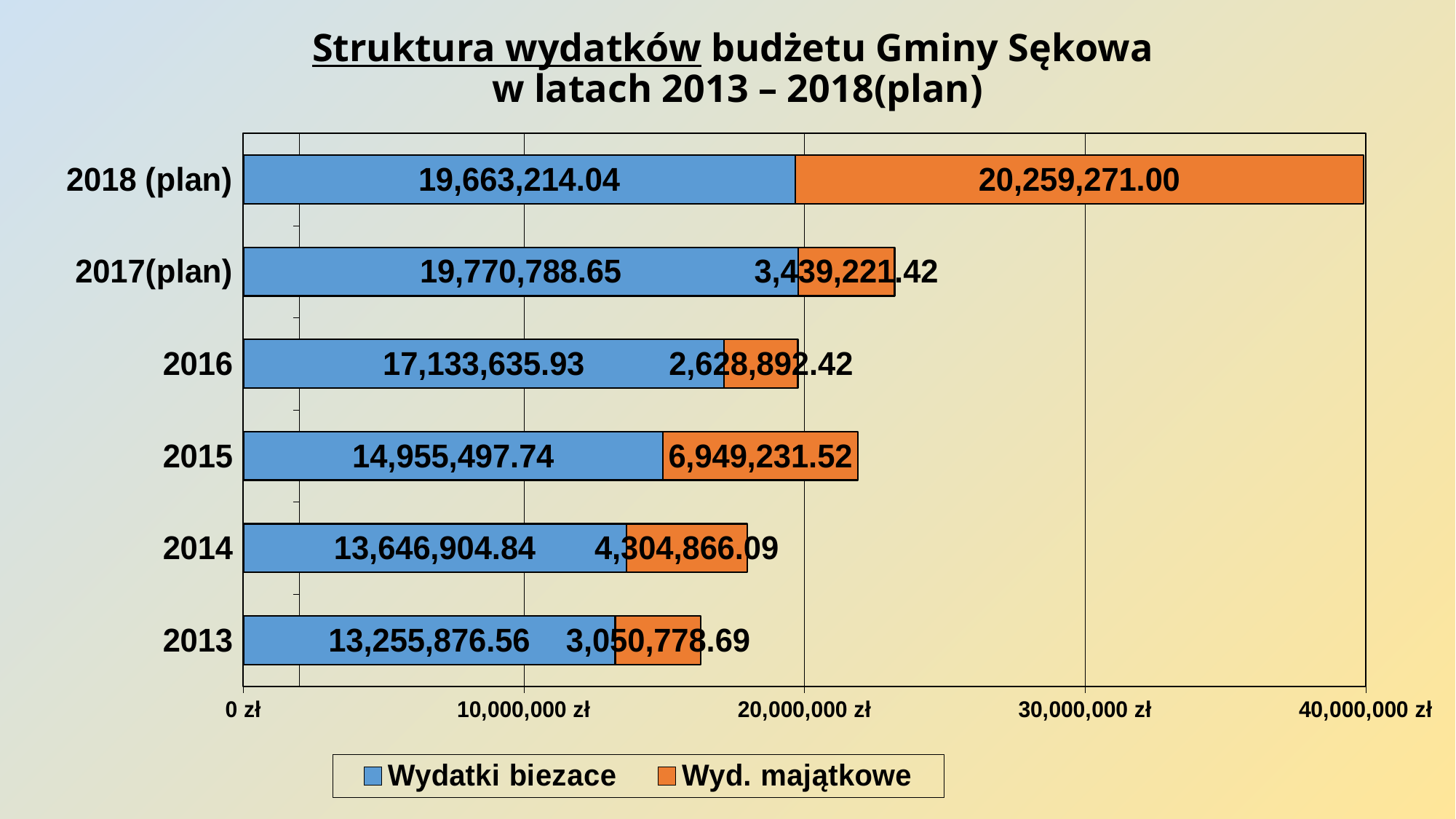
Which is larger: Wyd. majątkowe in 2015 or in 2014? 2015 Is the total of the 2014 bar greater or less than 20,000,000 zł? less What is the value of Wyd. majątkowe for 2014? 4,304,866.09 What is the total of the 2015 bar (Wydatki biezace plus Wyd. majątkowe)? 21,904,729.26 What kind of chart is shown on the slide? Stacked bar chart How many series does the legend list? 2 What is the value of Wyd. majątkowe for 2018 (plan)? 20,259,271.00 Which year has the lowest value of Wydatki biezace? 2013 Which year has the highest value of Wyd. majątkowe? 2018 (plan) How many years are shown on the chart? 6 What is the difference between Wyd. majątkowe in 2018 (plan) and in 2017(plan)? 16,820,049.58 What is the value of Wydatki biezace for 2016? 17,133,635.93